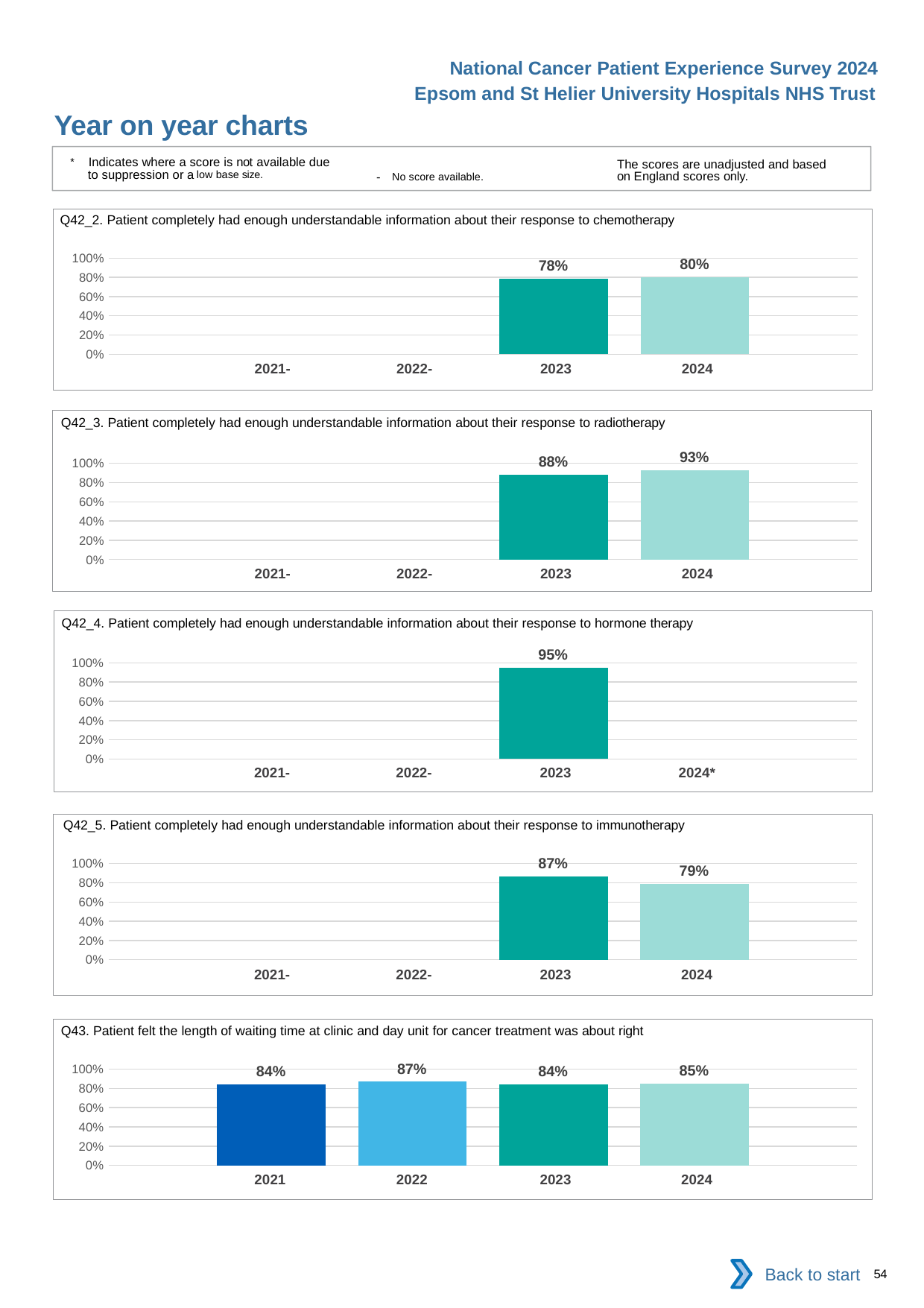
What type of chart is the Q43 chart (waiting time at clinic and day unit)? Bar chart In the Q42_2 chart (chemotherapy), what is the value for 2024? 80% In the Q42_3 chart (radiotherapy), which year has the higher value, 2023 or 2024? 2024 In the Q42_3 chart (radiotherapy), what is the value for 2023? 88% In the Q43 chart (waiting time at clinic and day unit), how many years have bars plotted? 4 In the Q43 chart (waiting time at clinic and day unit), what is the value for 2021? 84% In the Q42_2 chart (chemotherapy), what is the difference between the 2024 and 2023 values? 2 percentage points In the Q42_4 chart (hormone therapy), what is the value for 2023? 95% In the Q42_5 chart (immunotherapy), what is the difference between the 2023 and 2024 values? 8 percentage points In the Q42_4 chart (hormone therapy), how many bars are plotted? 1 In the Q42_5 chart (immunotherapy), what is the value for 2024? 79% In the Q43 chart (waiting time at clinic and day unit), which year has the highest value? 2022